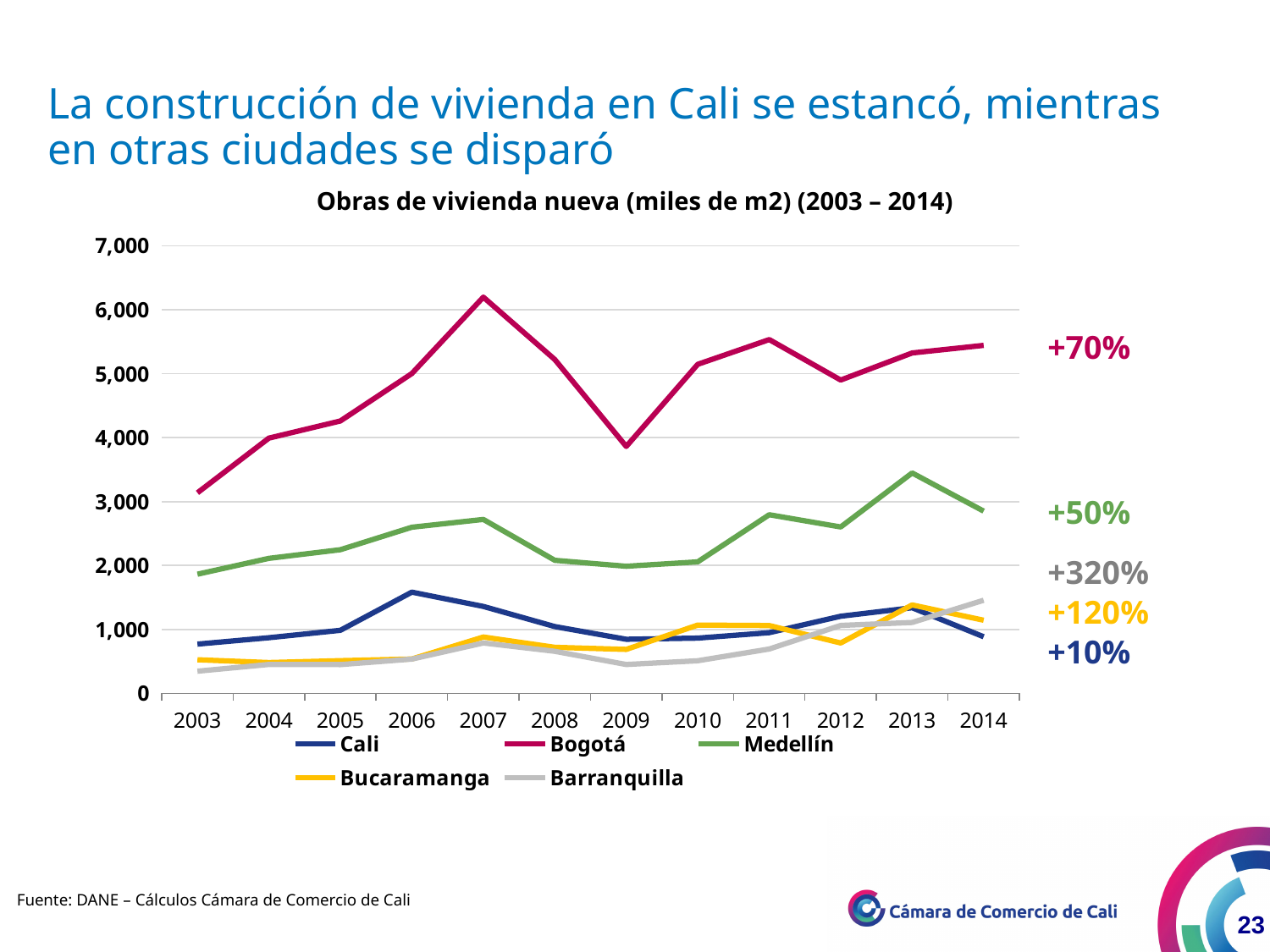
What percentage change is annotated next to the Barranquilla line? +320% How many years are plotted along the x axis? 12 How many series does the legend list? 5 Is the value for Bogotá in 2007 greater or less than 6,000? greater What kind of chart is shown on the slide? line chart Is the value for Bogotá in 2009 greater or less than 4,000? less Which city has the highest value in 2014? Bogotá Which is larger in 2010, the value for Medellín or the value for Cali? Medellín Does the Bogotá line rise or fall between 2003 and 2007? rise Is the value for Medellín in 2013 greater or less than 3,000? greater In which year is the Bogotá line at its lowest? 2003 In which year does the Bogotá line reach its highest point? 2007